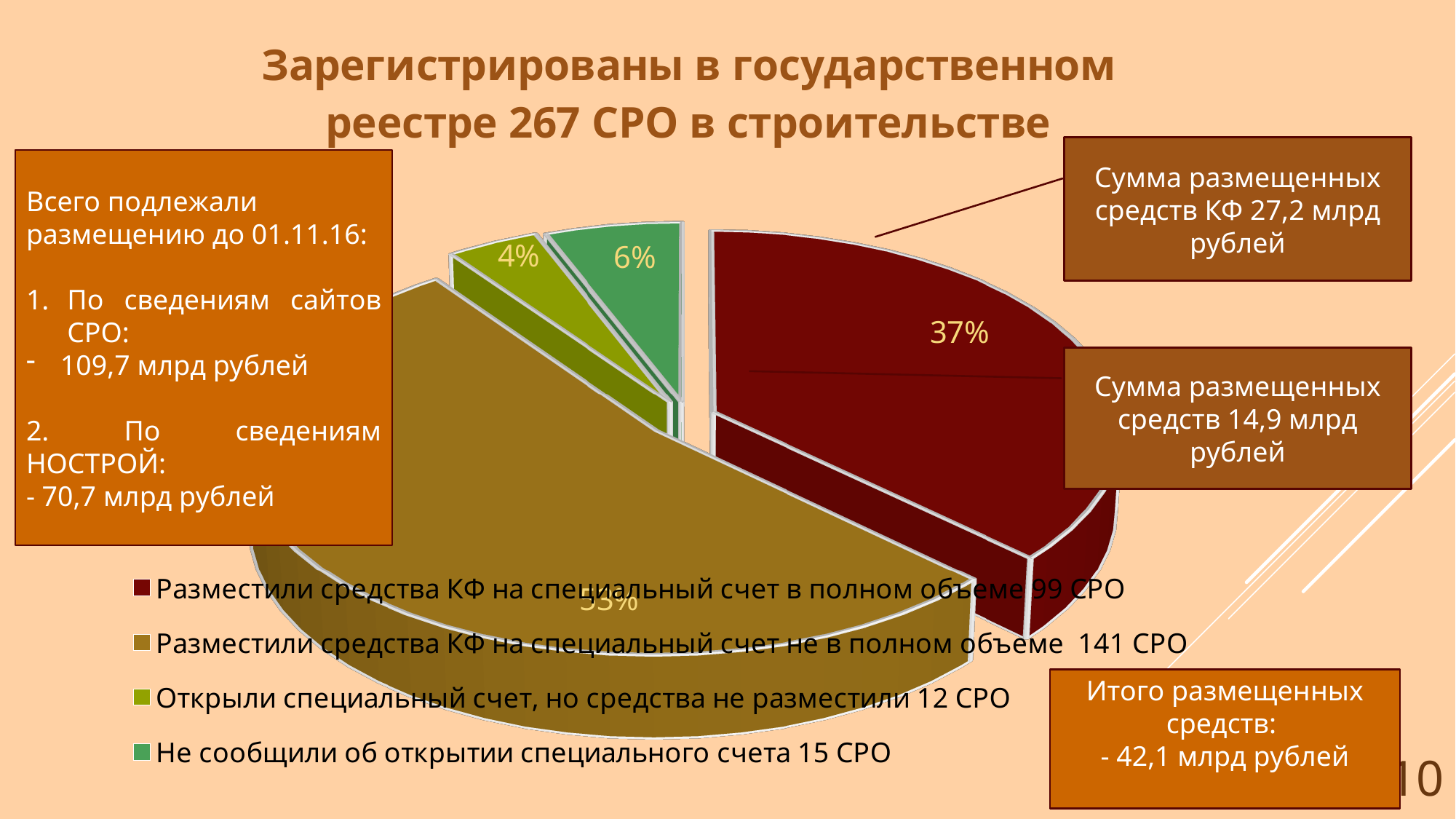
What is the difference in percentage points between the 37% slice and the 6% slice? 31 Which legend category has the smallest slice of the pie? Открыли специальный счет, но средства не разместили 12 СРО How many slices does the pie chart have? 4 What percentage is shown for the slice 'Открыли специальный счет, но средства не разместили 12 СРО'? 4% How many entries does the legend list? 4 Which slice is larger: the one for 'Не сообщили об открытии специального счета 15 СРО' or the one for 'Открыли специальный счет, но средства не разместили 12 СРО'? Не сообщили об открытии специального счета 15 СРО What percentage is shown for the slice 'Не сообщили об открытии специального счета 15 СРО'? 6% How many СРО are listed in the legend as having placed KF funds on a special account in full? 99 СРО What type of chart is shown on the slide? pie chart What percentage is shown for the slice 'Разместили средства КФ на специальный счет в полном объеме 99 СРО'? 37% Which legend category has the largest slice of the pie? Разместили средства КФ на специальный счет не в полном объеме 141 СРО What colour is the slice representing 'Разместили средства КФ на специальный счет в полном объеме 99 СРО'? dark red